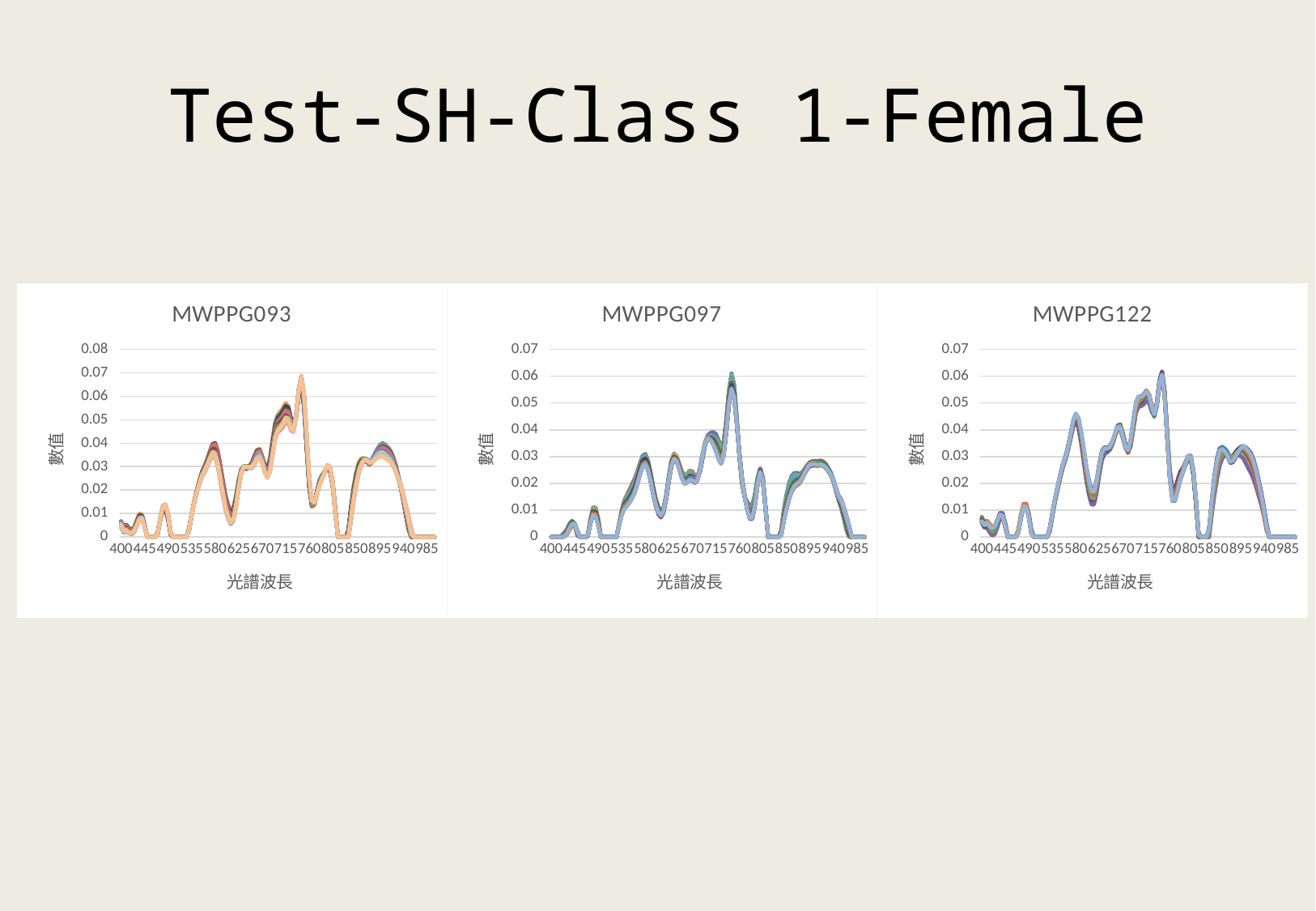
In the MWPPG122 chart, is the peak value near 760 greater or less than 0.05? greater In the MWPPG097 chart, is the value at 400 greater or less than 0.01? less In the MWPPG122 chart, is the value at 580 greater or less than 0.04? greater What is the title of the leftmost chart? MWPPG093 In the MWPPG097 chart, what is the highest value shown on the y axis? 0.07 How many charts are shown on the slide? 3 What is the title of the rightmost chart? MWPPG122 In the MWPPG093 chart, what is the highest value shown on the y axis? 0.08 What kind of chart is MWPPG093? line chart